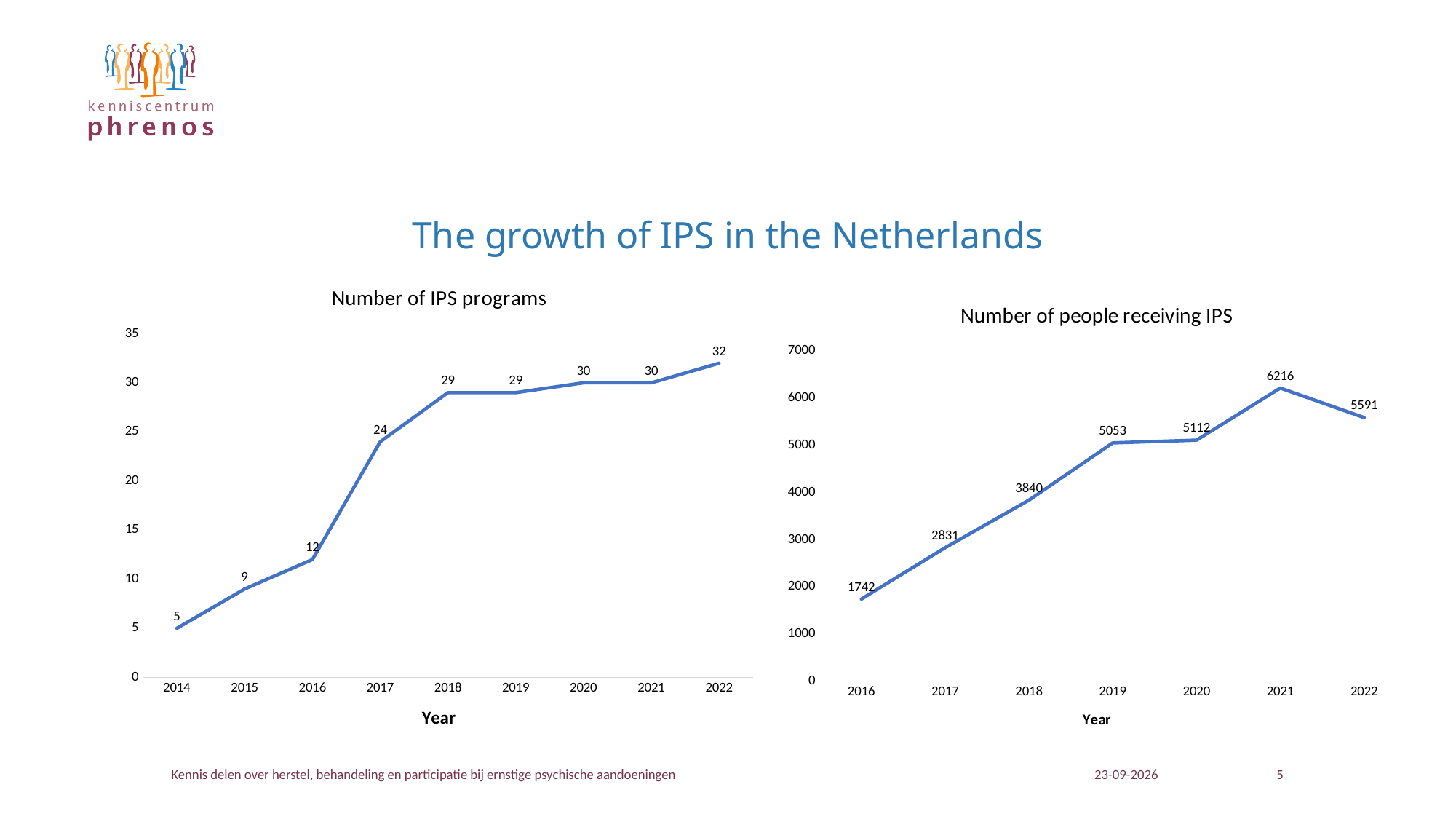
In the 'Number of IPS programs' chart, do the values rise or fall from 2014 to 2022? Rise In the 'Number of IPS programs' chart, what is the value for 2017? 24 In the 'Number of people receiving IPS' chart, is the value for 2017 greater or less than 3000? less In the 'Number of people receiving IPS' chart, what is the difference between the values for 2021 and 2022? 625 In the 'Number of people receiving IPS' chart, which is larger, the value for 2018 or the value for 2020? 2020 In the 'Number of people receiving IPS' chart, which year has the highest value? 2021 In the 'Number of IPS programs' chart, what is the difference between the values for 2018 and 2016? 17 How many years are plotted in the 'Number of people receiving IPS' chart? 7 In the 'Number of people receiving IPS' chart, what is the value for 2019? 5053 In the 'Number of IPS programs' chart, which year has the lowest value? 2014 What kind of chart is the 'Number of IPS programs' chart? Line chart How many years are plotted in the 'Number of IPS programs' chart? 9